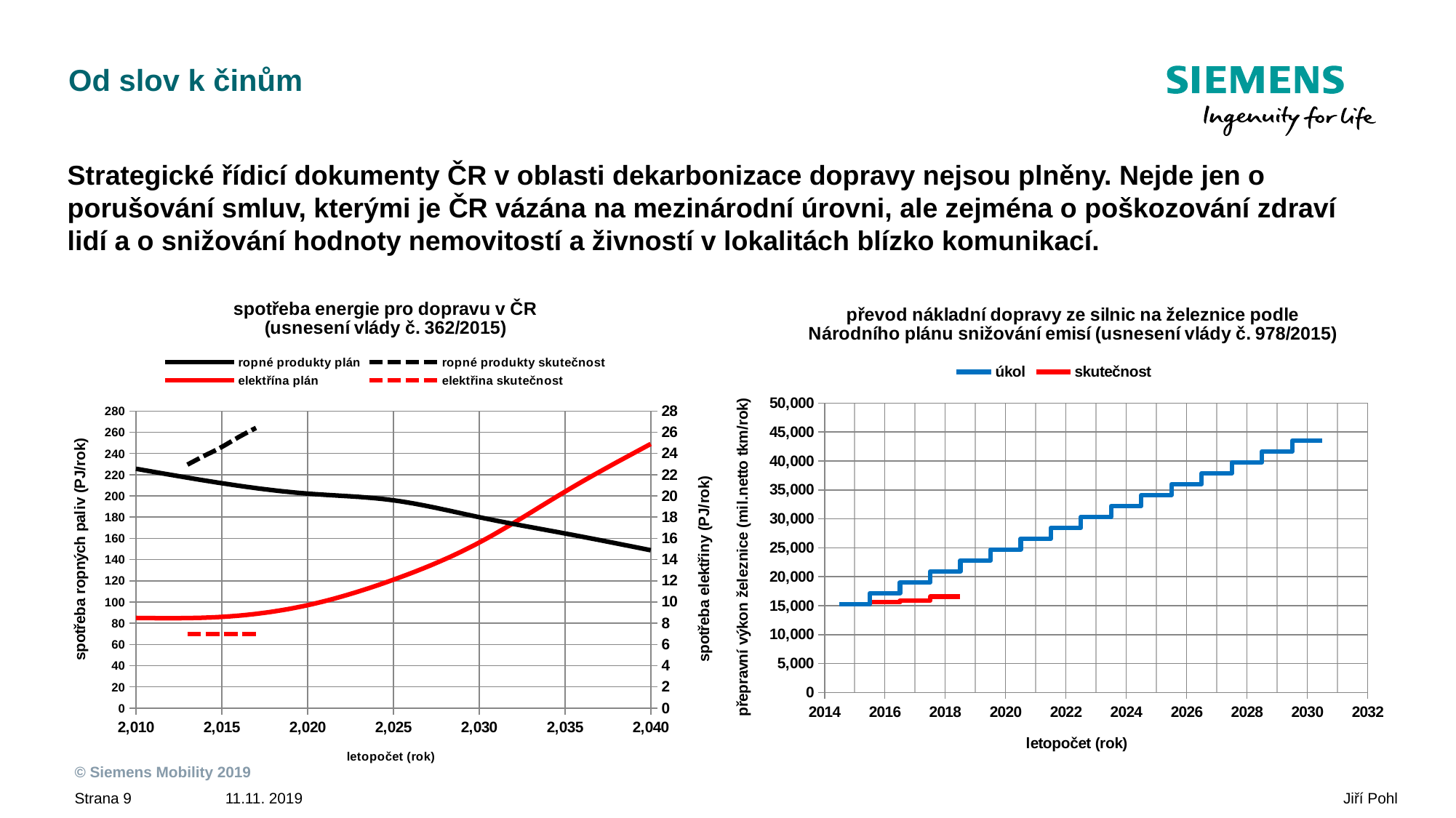
In the left chart ('spotřeba energie pro dopravu v ČR'), around 2016, which is higher: 'ropné produkty skutečnost' or 'ropné produkty plán'? ropné produkty skutečnost In the left chart ('spotřeba energie pro dopravu v ČR'), is the value of 'ropné produkty plán' in 2010 greater or less than 200 PJ/rok? greater In the right chart ('převod nákladní dopravy ze silnic na železnice'), is the value of 'úkol' in 2030 greater or less than 40,000? greater In the left chart ('spotřeba energie pro dopravu v ČR'), is the value of 'elektřina plán' in 2040 greater or less than 20 PJ/rok on the right axis? greater In the left chart ('spotřeba energie pro dopravu v ČR'), does the 'ropné produkty plán' series rise or fall from 2010 to 2040? fall In the right chart ('převod nákladní dopravy ze silnic na železnice'), does the 'úkol' series rise or fall over time? rise In the left chart ('spotřeba energie pro dopravu v ČR'), does the 'elektřina plán' series rise or fall from 2010 to 2040? rise How many series does the legend of the right chart ('převod nákladní dopravy ze silnic na železnice') list? 2 How many series does the legend of the left chart ('spotřeba energie pro dopravu v ČR') list? 4 What kind of chart is the left chart, 'spotřeba energie pro dopravu v ČR'? line chart In the right chart ('převod nákladní dopravy ze silnic na železnice'), in 2018, which is larger: 'úkol' or 'skutečnost'? úkol